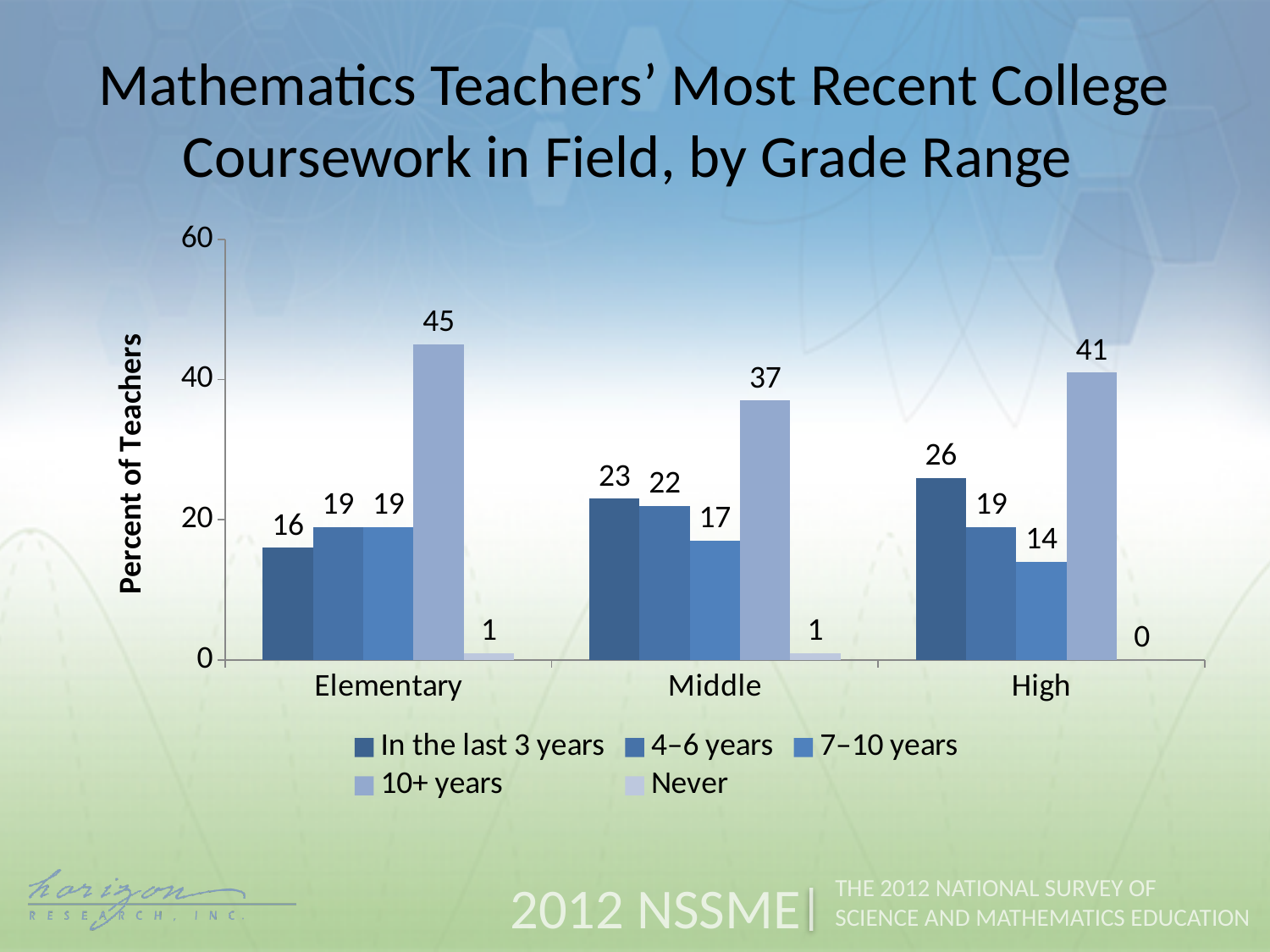
Which grade range has the highest percentage of teachers whose most recent coursework was 10+ years ago? Elementary What is the difference between the 10+ years percentage for Elementary and for Middle? 8 What percent of middle school mathematics teachers had coursework in field 7–10 years ago? 17 What percent of elementary mathematics teachers had their most recent college coursework in field 10+ years ago? 45 What kind of chart is shown on the slide? Bar chart What percent of high school mathematics teachers never had college coursework in field? 0 Which is larger: the 4–6 years value for Middle or the 4–6 years value for High? Middle How many series does the legend list? 5 What percent of high school mathematics teachers had coursework in field in the last 3 years? 26 Which grade range has the lowest percentage of teachers with coursework in the last 3 years? Elementary Is the 10+ years value for High greater or less than 40? greater How many grade ranges are shown on the x axis? 3